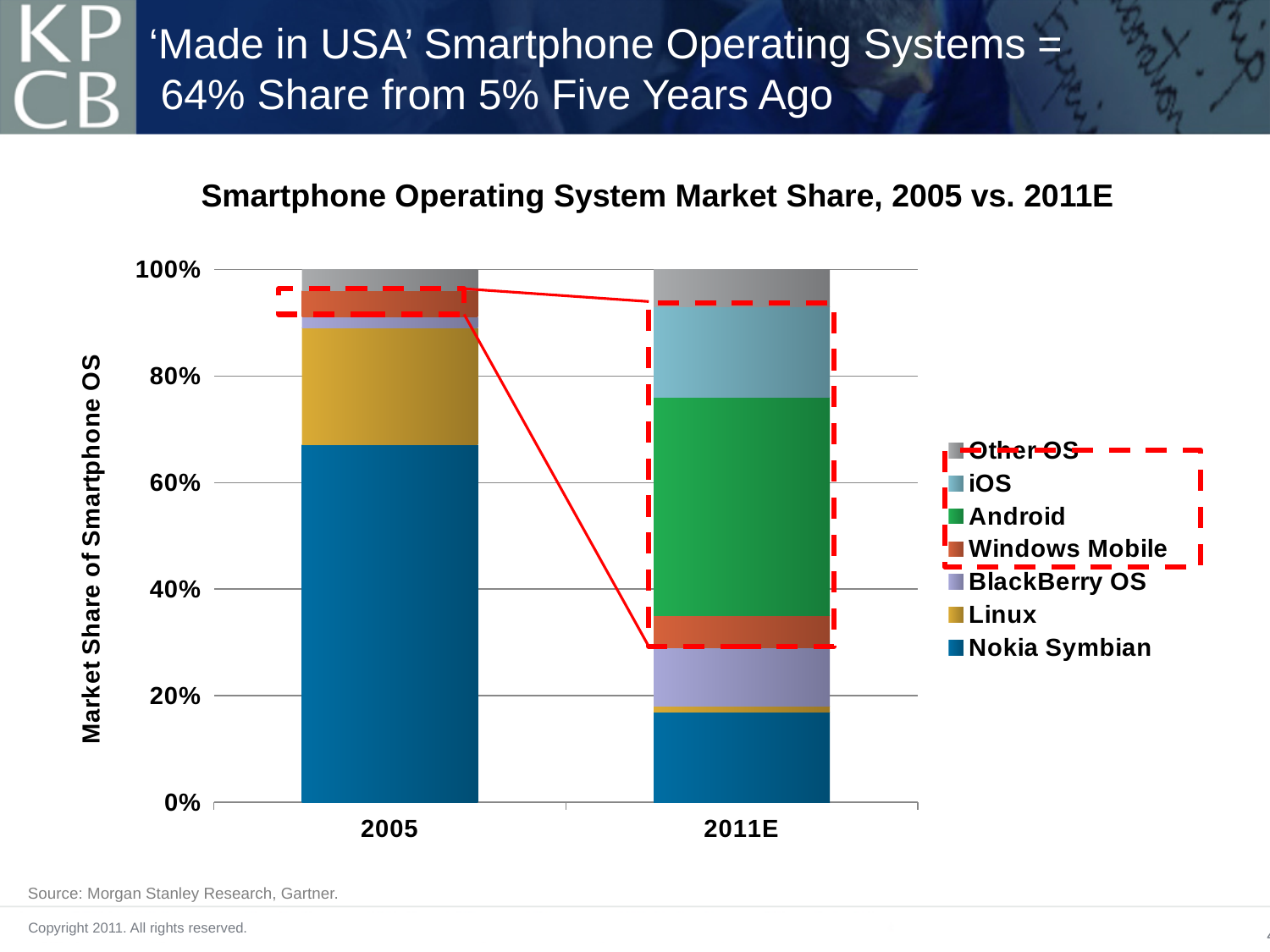
In 2011E, which has the larger share, Android or iOS? Android Is the Nokia Symbian share in 2011E greater or less than 20%? less What is the total height of the stacked bar for 2005? 100% Does the Nokia Symbian share rise or fall from 2005 to 2011E? Fall What kind of chart is shown on the slide? Stacked bar chart How many series does the legend list? 7 What is the title of the chart? Smartphone Operating System Market Share, 2005 vs. 2011E What is the label of the y axis? Market Share of Smartphone OS Is the Android share in 2011E greater or less than 20%? greater How many categories are shown on the x axis? 2 Is the Nokia Symbian share in 2005 greater or less than 60%? greater